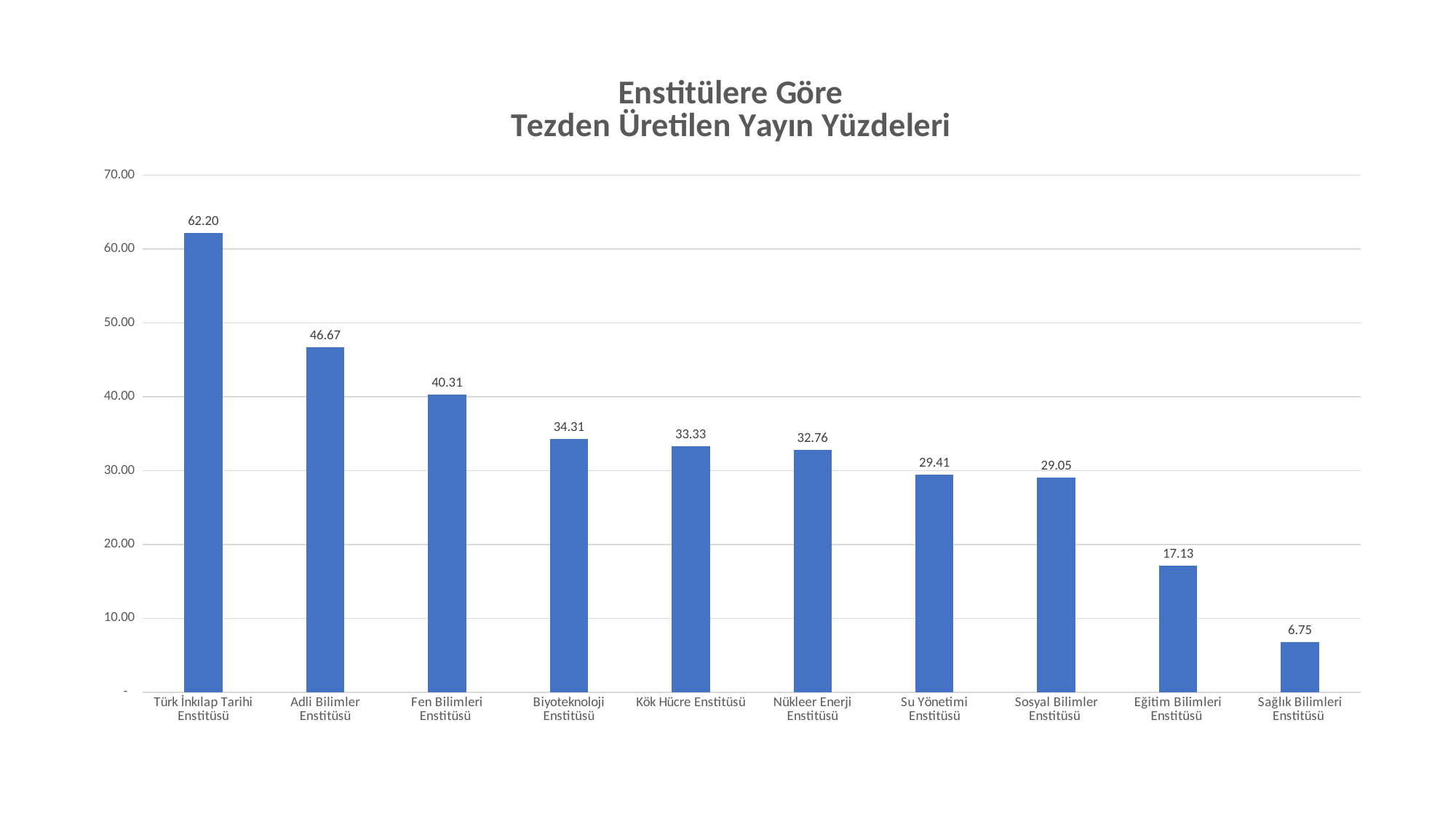
What is the difference between the values for Türk İnkılap Tarihi Enstitüsü and Adli Bilimler Enstitüsü? 15.53 Which is larger, the value for Kök Hücre Enstitüsü or the value for Eğitim Bilimleri Enstitüsü? Kök Hücre Enstitüsü How many institutes are shown on the chart? 10 Is the value for Nükleer Enerji Enstitüsü greater or less than 30.00? greater Which institute has the highest value? Türk İnkılap Tarihi Enstitüsü What kind of chart is shown on the slide? bar chart What is the value for Sosyal Bilimler Enstitüsü? 29.05 What is the value for Fen Bilimleri Enstitüsü? 40.31 What is the value for Eğitim Bilimleri Enstitüsü? 17.13 What is the difference between the values for Biyoteknoloji Enstitüsü and Sağlık Bilimleri Enstitüsü? 27.56 What is the title of the chart? Enstitülere Göre Tezden Üretilen Yayın Yüzdeleri Which institute has the lowest value? Sağlık Bilimleri Enstitüsü